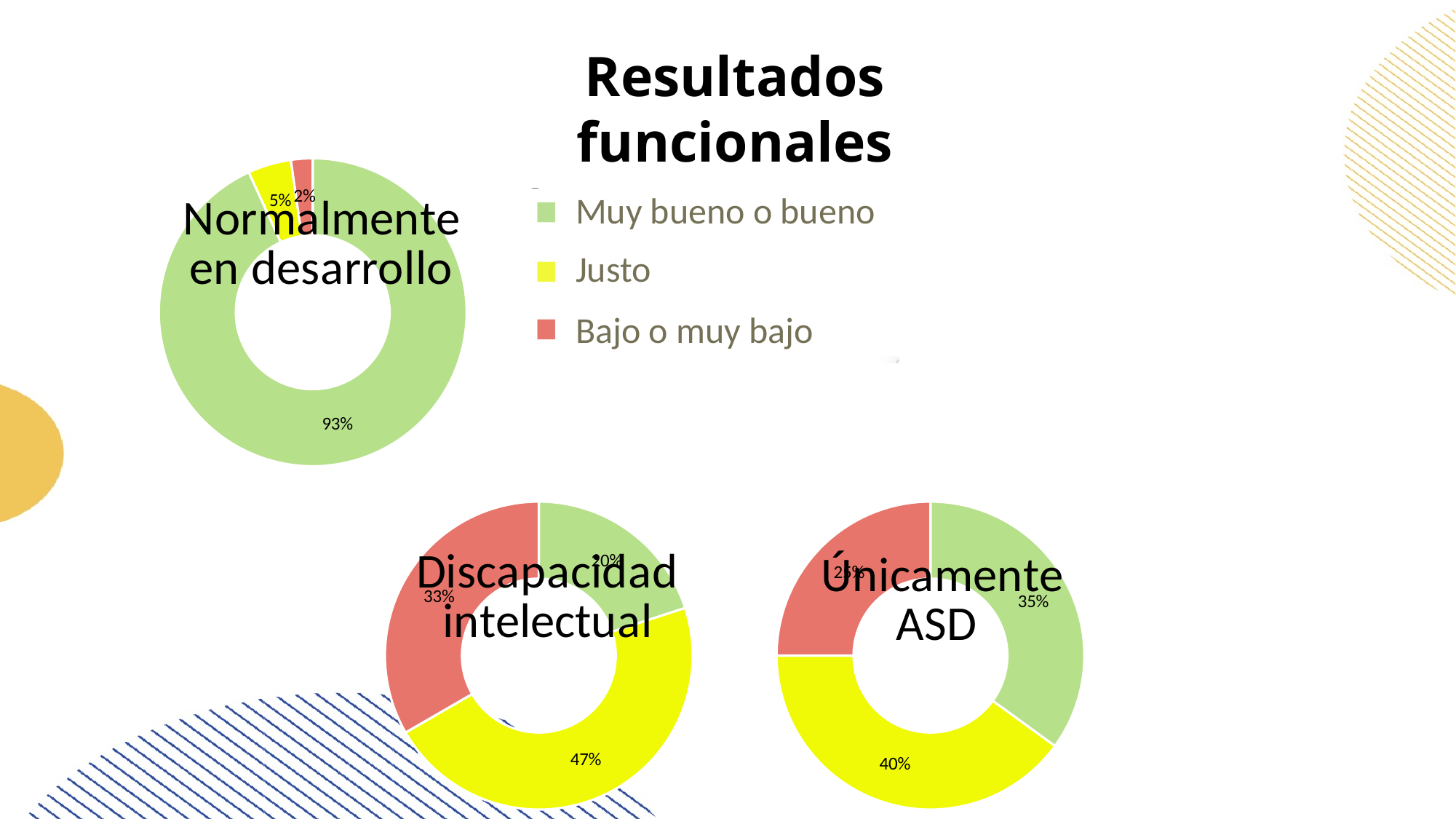
In the 'Discapacidad intelectual' chart, which category has the largest share? Justo In the 'Únicamente ASD' chart, what share is 'Justo'? 40% In the 'Discapacidad intelectual' chart, what share is 'Justo'? 47% In the 'Discapacidad intelectual' chart, what share is 'Bajo o muy bajo'? 33% In the 'Normalmente en desarrollo' chart, what share is 'Bajo o muy bajo'? 2% In the 'Discapacidad intelectual' chart, what is the difference between the 'Justo' share and the 'Bajo o muy bajo' share? 14% How many series does the legend list? 3 In the 'Únicamente ASD' chart, what share is 'Muy bueno o bueno'? 35% In the 'Normalmente en desarrollo' chart, which category has the smallest share? Bajo o muy bajo What kind of chart is used for 'Únicamente ASD'? Doughnut chart In the 'Normalmente en desarrollo' chart, what share is 'Muy bueno o bueno'? 93% In the 'Normalmente en desarrollo' chart, what share is 'Justo'? 5%